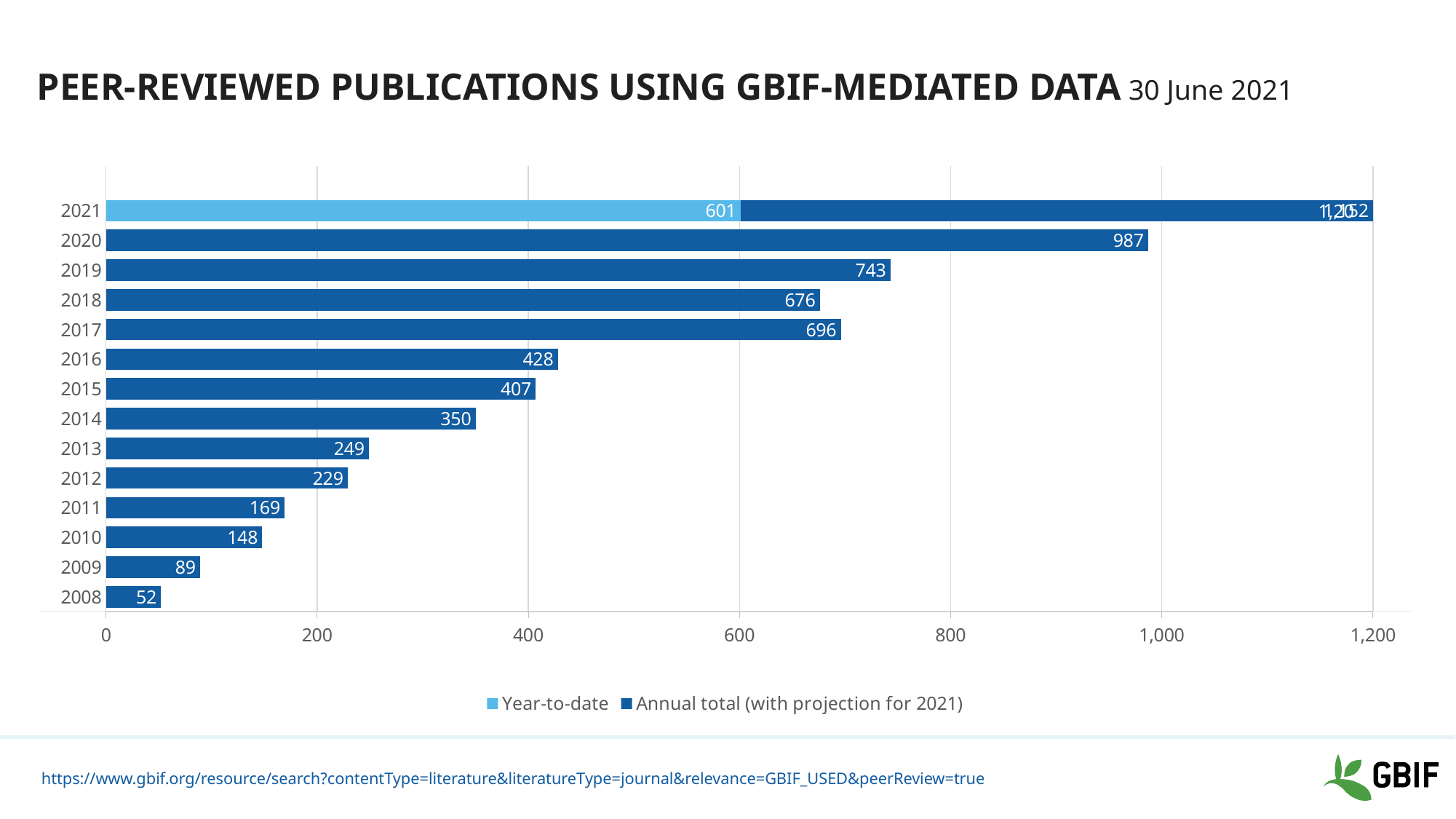
Is the total bar for 2021 greater or less than 1,000? greater Which year has the longest bar? 2021 How many years are shown on the chart? 14 Which year has the lowest value? 2008 Which year has the larger value, 2017 or 2018? 2017 How many series does the legend list? 2 What is the annual total of peer-reviewed publications for 2020? 987 What is the year-to-date value shown for 2021? 601 What kind of chart is shown on the slide? Bar chart What is the difference between the values for 2020 and 2019? 244 What is the value for 2008? 52 What is the value for 2014? 350